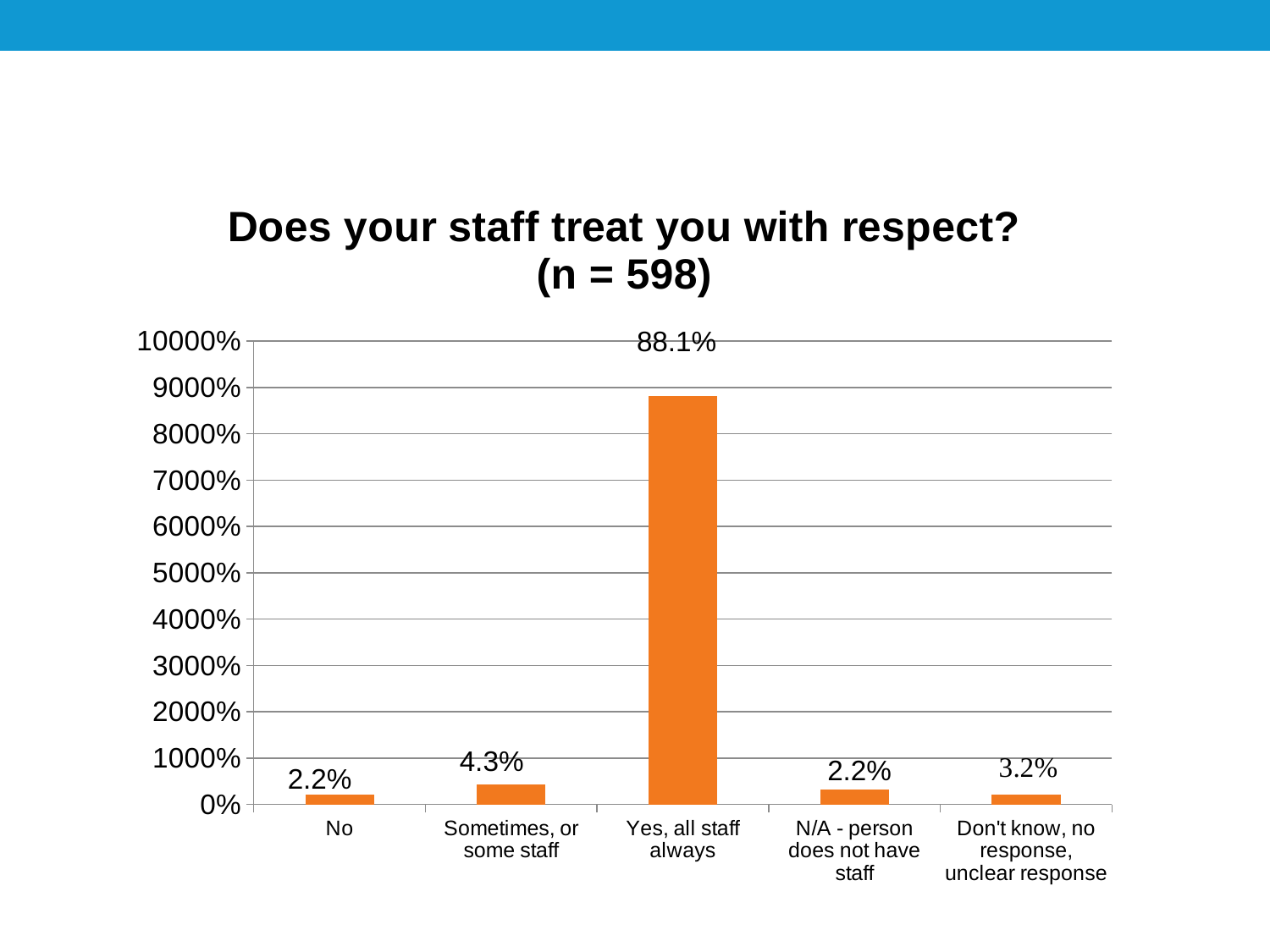
What is the value for "Yes, all staff always"? 88.1% What is the difference between the values for "Sometimes, or some staff" and "Don't know, no response, unclear response"? 1.1% What is the value for "No"? 2.2% How many categories are shown on the x axis? 5 What is the title of the chart? Does your staff treat you with respect? (n = 598) What is the value for "Sometimes, or some staff"? 4.3% What is the value for "Don't know, no response, unclear response"? 3.2% What is the difference between the values for "Yes, all staff always" and "Sometimes, or some staff"? 83.8% What is the value for "N/A - person does not have staff"? 2.2% What kind of chart is shown on the slide? Bar chart Which category has the highest value? Yes, all staff always Which is larger, the value for "Sometimes, or some staff" or the value for "Don't know, no response, unclear response"? Sometimes, or some staff